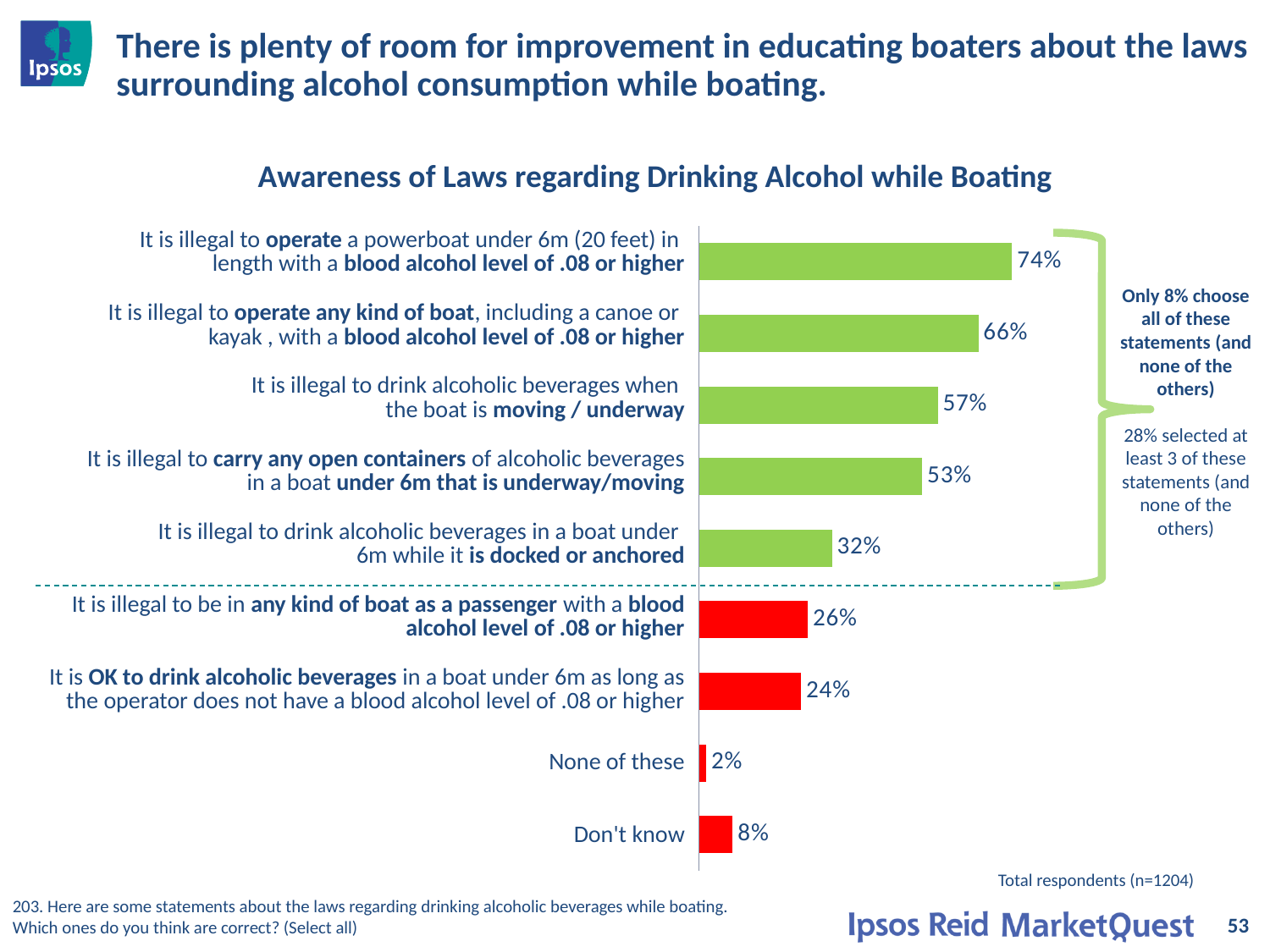
Which has a higher percentage: 'any kind of boat as a passenger' or 'OK to drink alcoholic beverages in a boat under 6m as long as the operator does not have a blood alcohol level of .08 or higher'? any kind of boat as a passenger What is the difference in percentage points between 'operate any kind of boat' (66%) and 'carry any open containers' (53%)? 13 What type of chart is shown on the slide? Bar chart Which statement has the highest percentage of respondents? It is illegal to operate a powerboat under 6m (20 feet) in length with a blood alcohol level of .08 or higher Which category has the lowest percentage? None of these What percentage of respondents said it is illegal to drink alcoholic beverages in a boat under 6m while it is docked or anchored? 32% What is the title of the chart? Awareness of Laws regarding Drinking Alcohol while Boating What percentage of respondents said it is illegal to drink alcoholic beverages when the boat is moving / underway? 57% What colour are the bars for the statements below the dashed line? Red How many categories are shown in the chart? 9 What percentage of respondents said it is illegal to operate a powerboat under 6m in length with a blood alcohol level of .08 or higher? 74% What percentage of respondents selected 'Don't know'? 8%